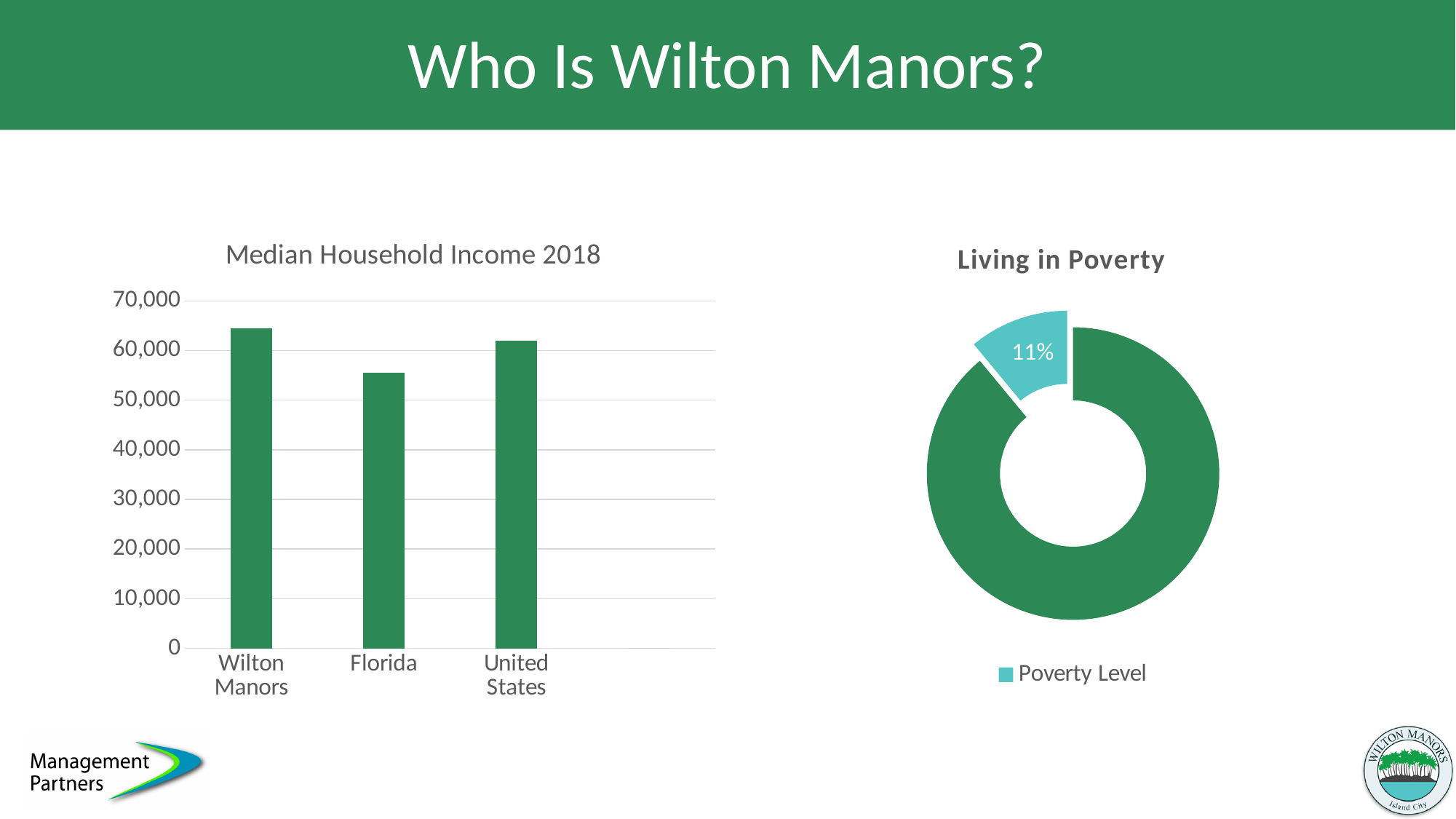
In the "Median Household Income 2018" chart, which category has the highest median household income? Wilton Manors How many categories are shown in the "Median Household Income 2018" chart? 3 What kind of chart is the "Median Household Income 2018" chart? bar chart In the "Median Household Income 2018" chart, is the value for Florida greater or less than 60,000? less In the "Median Household Income 2018" chart, which category has the lowest median household income? Florida What kind of chart is the "Living in Poverty" chart? doughnut chart What entry does the legend of the "Living in Poverty" chart list? Poverty Level In the "Median Household Income 2018" chart, is the value for United States greater or less than 50,000? greater In the "Median Household Income 2018" chart, is the value for Wilton Manors greater or less than 60,000? greater In the "Median Household Income 2018" chart, which is larger, the value for Florida or the value for United States? United States In the "Median Household Income 2018" chart, which is larger, the value for Wilton Manors or the value for Florida? Wilton Manors In the "Living in Poverty" chart, what percentage is shown for the Poverty Level slice? 11%